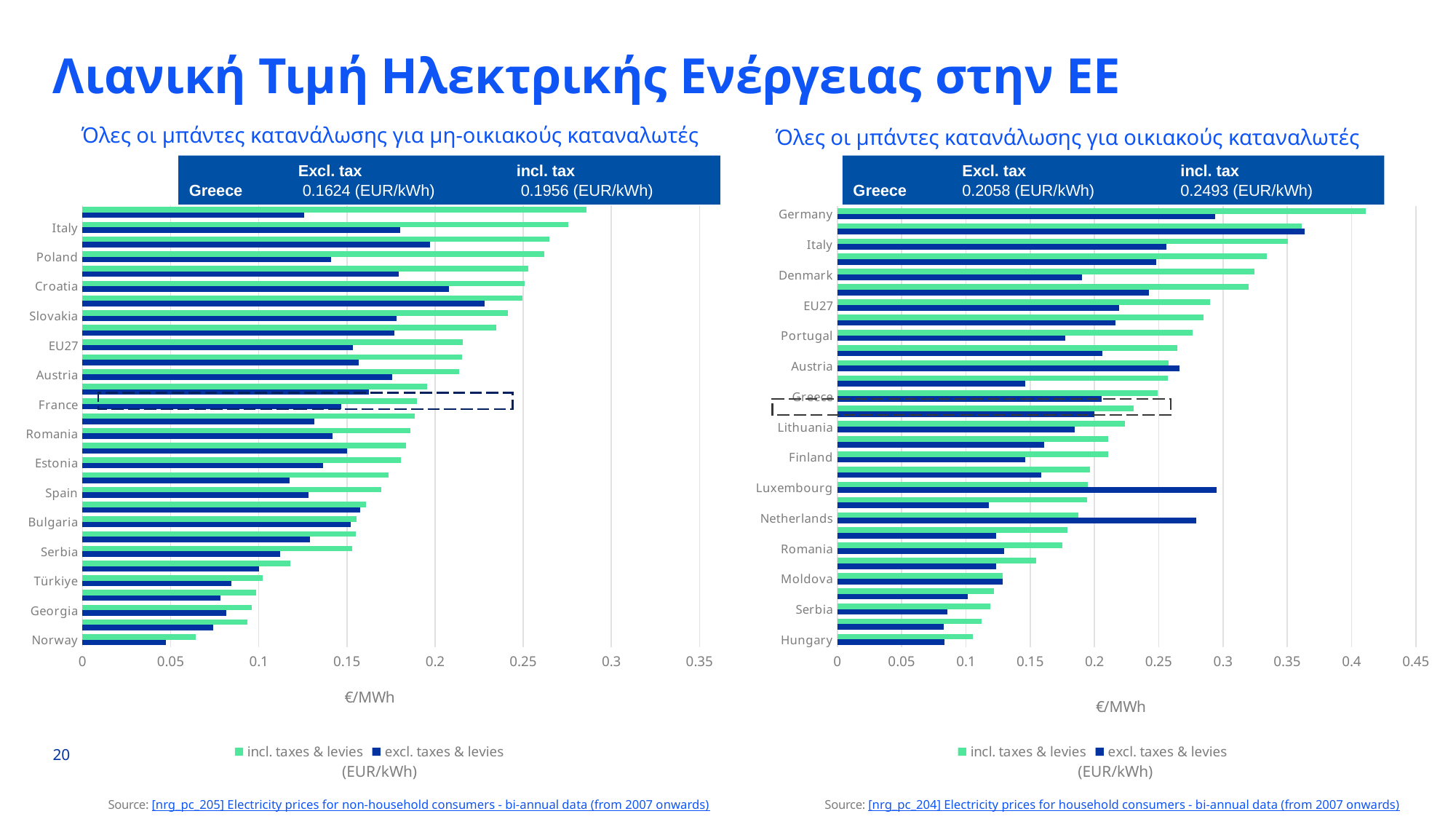
In the right chart (household consumers), what is the Greece price including tax shown in the header box? 0.2493 (EUR/kWh) In the right chart (household consumers), what is the difference between the Greece incl. tax and excl. tax values shown in the header box? 0.0435 In the left chart (non-household consumers), what is the Greece price excluding tax shown in the header box? 0.1624 (EUR/kWh) In the left chart (non-household consumers), which series is shown in green according to the legend? incl. taxes & levies In the right chart (household consumers), which labelled country has the lowest incl. taxes & levies value? Hungary In the right chart (household consumers), which is larger for Luxembourg: the incl. taxes & levies bar or the excl. taxes & levies bar? excl. taxes & levies In the right chart (household consumers), is the incl. taxes & levies value for Germany greater or less than 0.35? greater What kind of chart is used on the left side of the slide for non-household consumers? Bar chart In the right chart (household consumers), which labelled country has the highest incl. taxes & levies value? Germany In the left chart (non-household consumers), what is the difference between the Greece incl. tax and excl. tax values shown in the header box? 0.0332 In the left chart (non-household consumers), is the incl. taxes & levies value for Norway greater or less than 0.1? less How many series does the legend of the right-hand chart (household consumers) list? 2